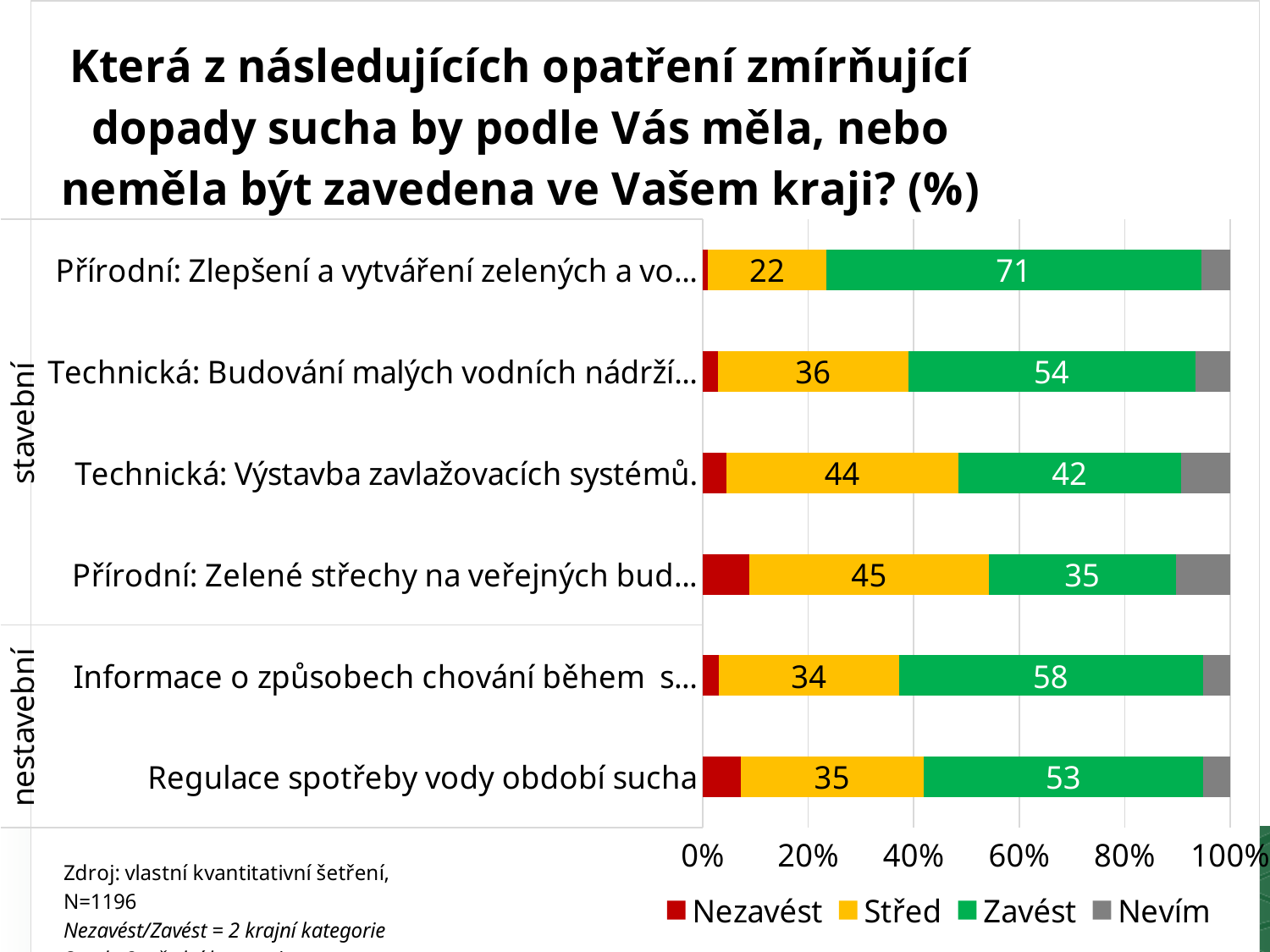
How many series does the legend list? 4 Which category has the highest Zavést value? Přírodní: Zlepšení a vytváření zelených a vo... What is the Zavést value for "Informace o způsobech chování během s..."? 58 What is the difference between the Zavést and Střed values for "Technická: Budování malých vodních nádrží..."? 18 Which category has the lowest Střed value? Přírodní: Zlepšení a vytváření zelených a vo... What is the Zavést value for "Regulace spotřeby vody období sucha"? 53 Which category has the lowest Zavést value? Přírodní: Zelené střechy na veřejných bud... How many categories (bars) does the chart show? 6 What kind of chart is shown on the slide? Stacked bar chart What is the Střed value for "Technická: Výstavba zavlažovacích systémů"? 44 Which is larger: the Zavést value for "Regulace spotřeby vody období sucha" or for "Informace o způsobech chování během s..."? Informace o způsobech chování během s... Is the Nezavést value for "Přírodní: Zelené střechy na veřejných bud..." greater or less than 20%? less